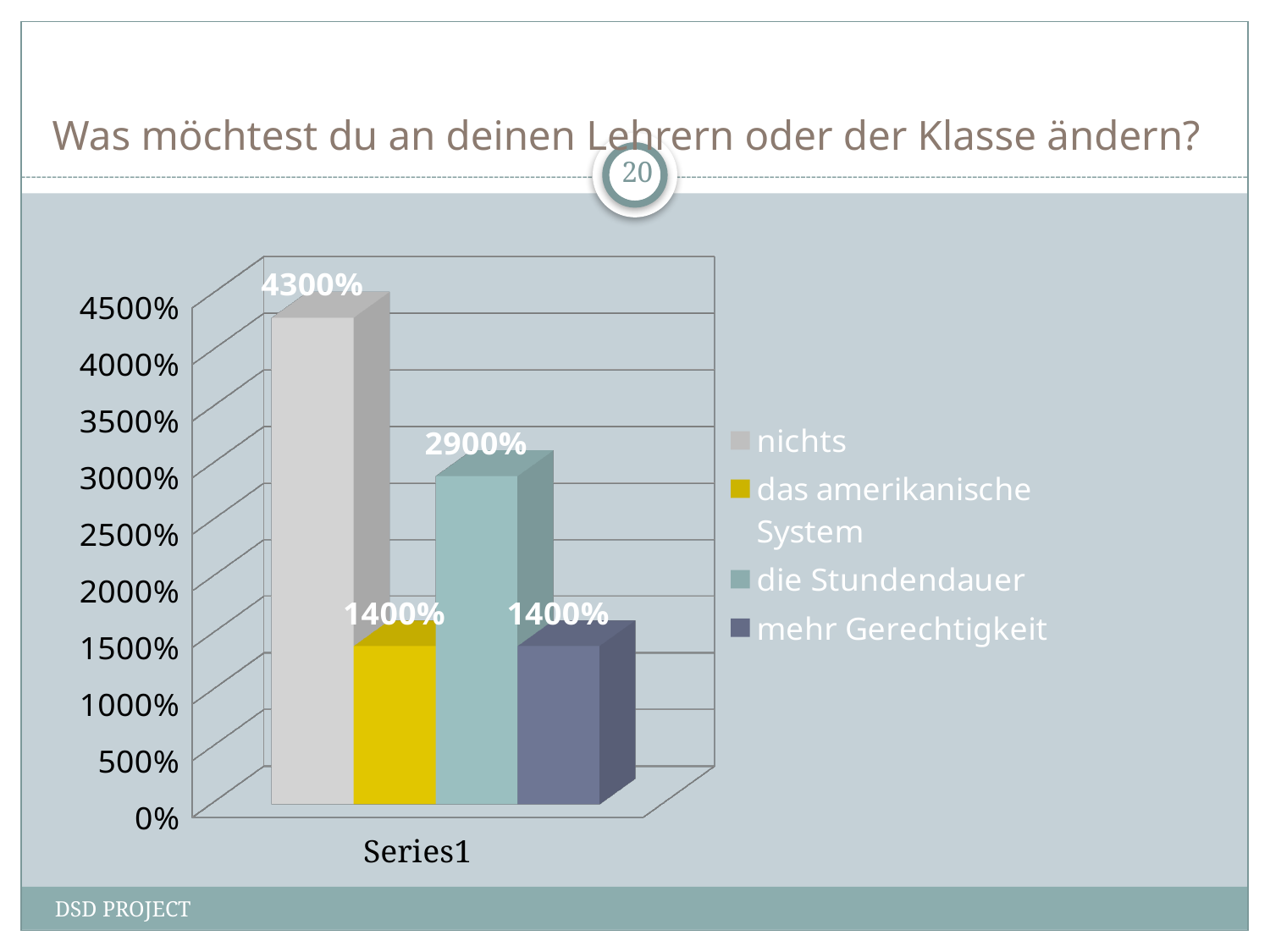
Which is larger, the value for "die Stundendauer" or the value for "das amerikanische System"? die Stundendauer Which legend entry has the highest value? nichts What is the difference between the values for "die Stundendauer" and "mehr Gerechtigkeit"? 1500% What kind of chart is shown on the slide? bar chart What is the label on the category axis below the bars? Series1 What is the value for "nichts"? 4300% How many series does the legend list? 4 What is the value for "das amerikanische System"? 1400% What is the value for "die Stundendauer"? 2900% What is the value for "mehr Gerechtigkeit"? 1400% Is the value for "nichts" greater or less than 4000%? greater What is the difference between the values for "nichts" and "die Stundendauer"? 1400%